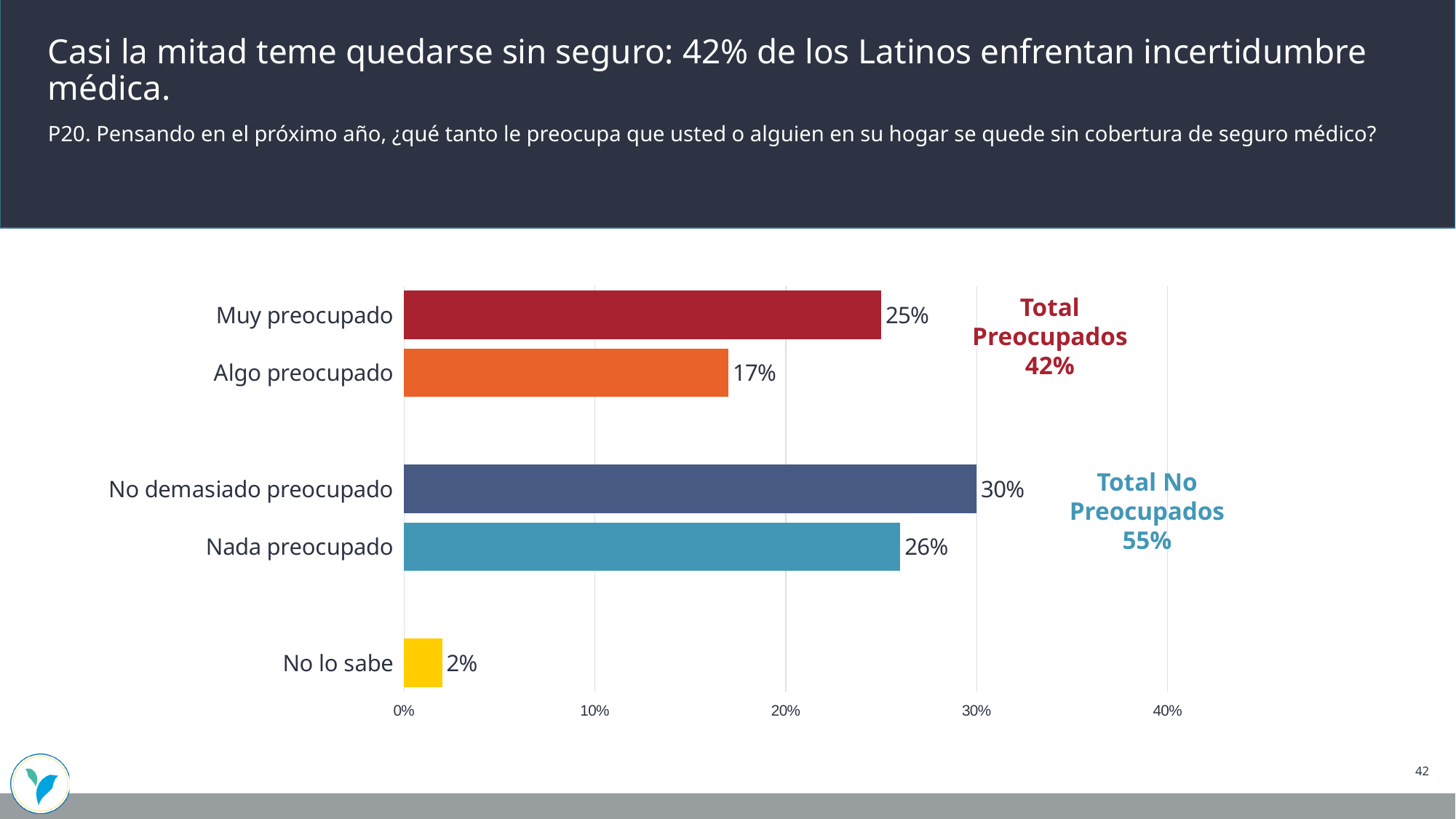
What is the difference between "No demasiado preocupado" and "Algo preocupado"? 13 percentage points What is the value for "Muy preocupado"? 25% How many categories are shown in the chart? 5 What is the value for "No lo sabe"? 2% Which category has the highest value? No demasiado preocupado What is the value for "Algo preocupado"? 17% What kind of chart is shown on the slide? Bar chart What percentage is shown for "Total No Preocupados"? 55% Which category has the lowest value? No lo sabe Which is larger, "Muy preocupado" or "Algo preocupado"? Muy preocupado What is the value for "No demasiado preocupado"? 30% What is the value for "Nada preocupado"? 26%